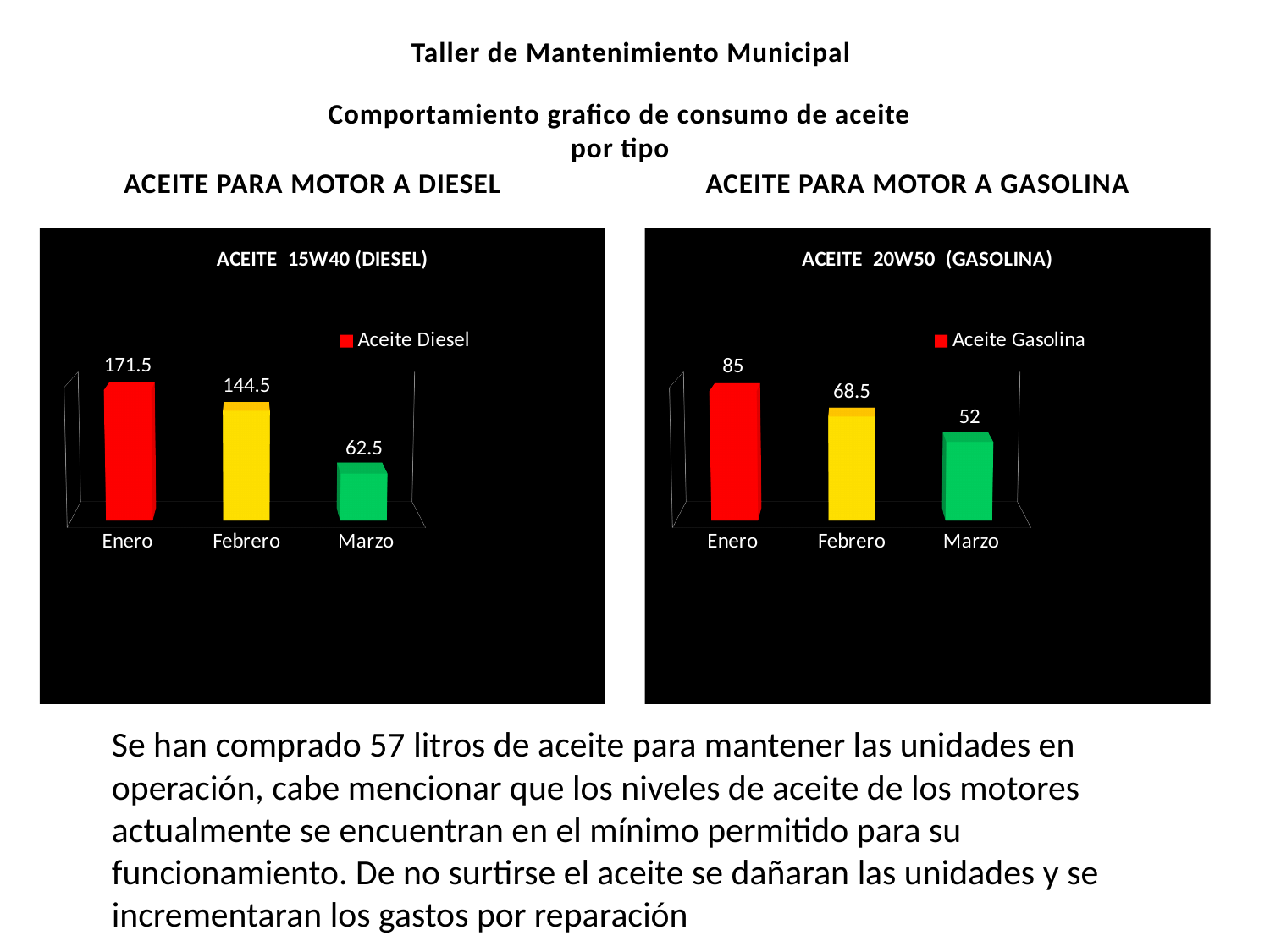
What is the legend entry in the ACEITE 20W50 (GASOLINA) chart? Aceite Gasolina How many series does the legend of the ACEITE 15W40 (DIESEL) chart list? 1 In the ACEITE 20W50 (GASOLINA) chart, what is the value for Febrero? 68.5 In the ACEITE 20W50 (GASOLINA) chart, what is the difference between the values for Febrero and Marzo? 16.5 In the ACEITE 15W40 (DIESEL) chart, which month has the lowest value? Marzo What kind of chart is the ACEITE 20W50 (GASOLINA) chart? Bar chart In the ACEITE 15W40 (DIESEL) chart, what is the value for Enero? 171.5 In the ACEITE 20W50 (GASOLINA) chart, which month has the highest value? Enero In the ACEITE 15W40 (DIESEL) chart, what is the difference between the values for Enero and Febrero? 27 In the ACEITE 15W40 (DIESEL) chart, which is larger, the value for Febrero or the value for Marzo? Febrero In the ACEITE 15W40 (DIESEL) chart, do the values rise or fall from Enero to Marzo? Fall How many months are shown in the ACEITE 20W50 (GASOLINA) chart? 3